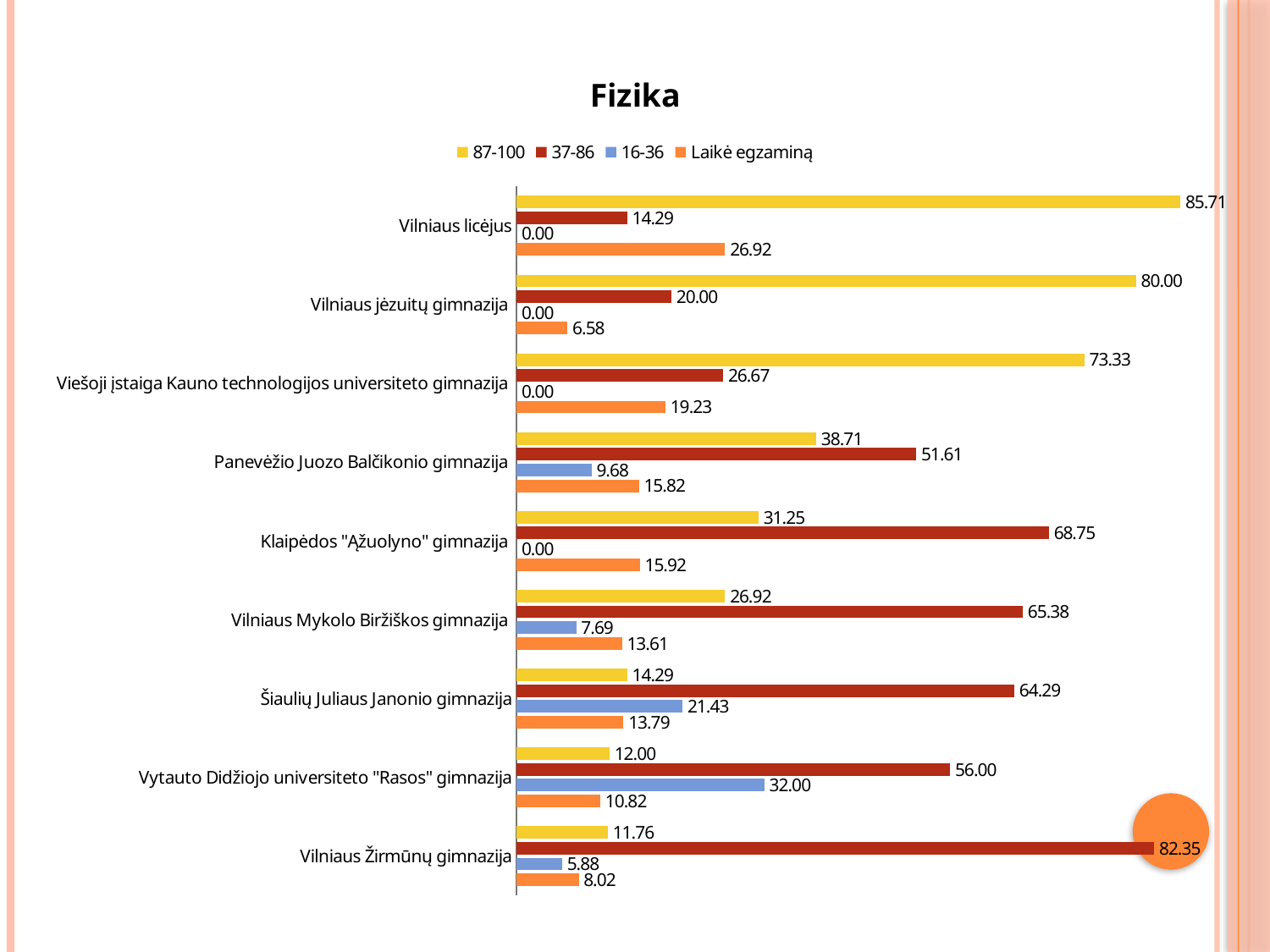
What is the value of the Laikė egzaminą series for Vilniaus jėzuitų gimnazija? 6.58 How many schools are shown on the chart? 9 What is the value of the 87-100 series for Vilniaus licėjus? 85.71 What is the title of the chart? Fizika What is the value of the 37-86 series for Vilniaus Žirmūnų gimnazija? 82.35 Which school has the highest value in the 87-100 series? Vilniaus licėjus What is the difference between the 37-86 value and the 87-100 value for Klaipėdos "Ąžuolyno" gimnazija? 37.50 How many series does the legend list? 4 Which is larger for Panevėžio Juozo Balčikonio gimnazija: the 87-100 value or the 37-86 value? 37-86 Which school has the lowest value in the Laikė egzaminą series? Vilniaus jėzuitų gimnazija What is the value of the 16-36 series for Vytauto Didžiojo universiteto "Rasos" gimnazija? 32.00 What kind of chart is shown on the slide? Bar chart